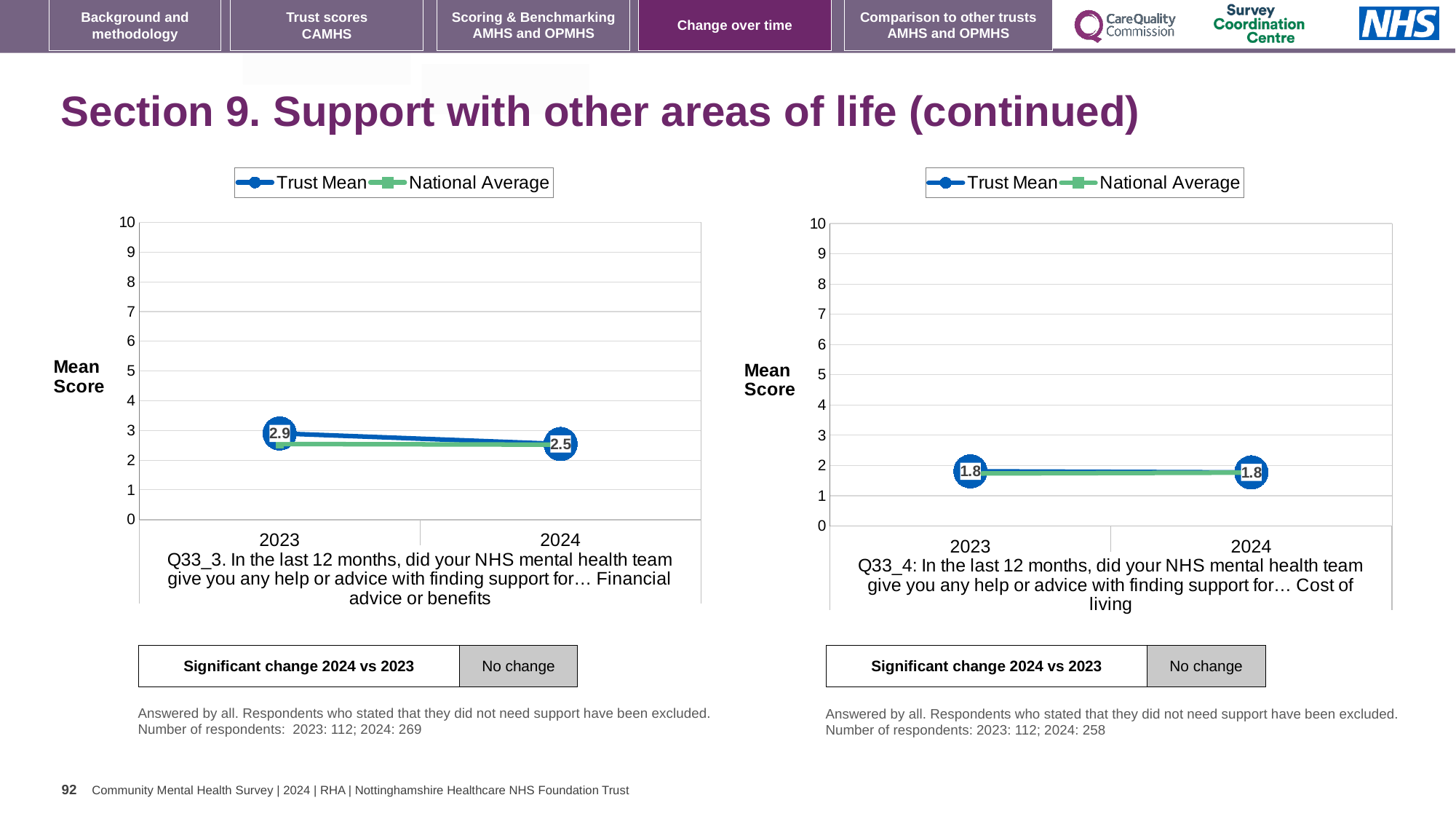
What kind of chart is the left chart (Q33_3)? line chart In the left chart (Q33_3, Financial advice or benefits), what is the Trust Mean for 2023? 2.9 In the left chart (Q33_3), by how much did the Trust Mean change from 2023 to 2024? 0.4 How many years are plotted on the x axis of the left chart (Q33_3)? 2 What does the 'Significant change 2024 vs 2023' box below the right chart (Q33_4) say? No change In the right chart (Q33_4), does the Trust Mean rise, fall or stay the same from 2023 to 2024? stays the same In the right chart (Q33_4), is the National Average for 2024 greater or less than 5? less In the left chart (Q33_3), which year has the higher Trust Mean, 2023 or 2024? 2023 In the left chart (Q33_3, Financial advice or benefits), what is the Trust Mean for 2024? 2.5 In the right chart (Q33_4, Cost of living), what is the Trust Mean for 2024? 1.8 How many series does the legend of the right chart (Q33_4) list? 2 In the left chart (Q33_3), does the Trust Mean rise or fall from 2023 to 2024? fall